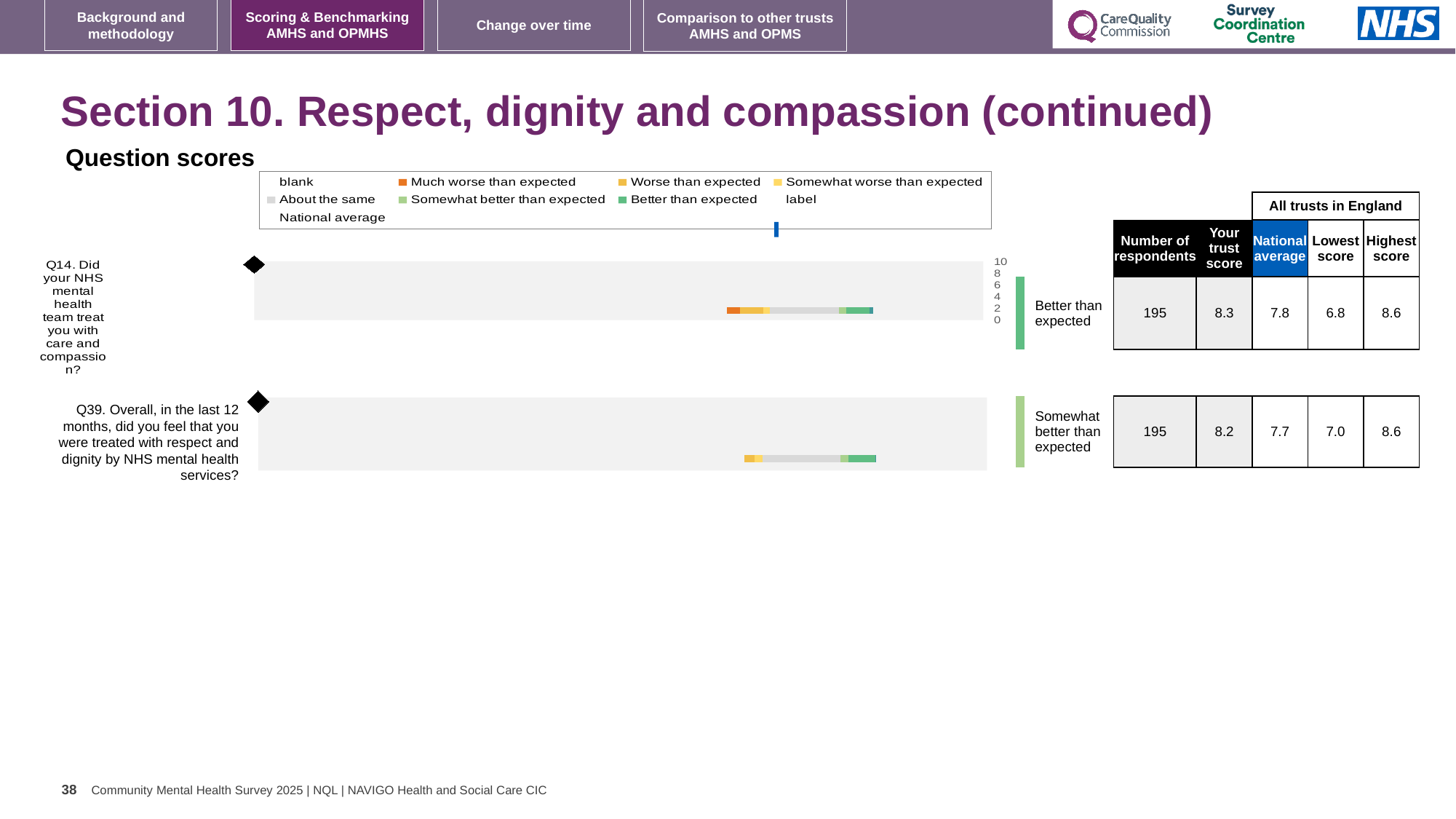
What is the trust score for Q14 in the question scores chart? 8.3 Which legend entry in the question scores chart is shown in orange? Much worse than expected How many entries does the legend of the question scores chart list? 9 What is the difference between the trust score and the national average for Q14? 0.5 What is the lowest score across all trusts in England for Q14? 6.8 How many respondents answered Q39? 195 What kind of chart is used to show the question scores on this slide? bar chart Which question has the higher trust score, Q14 or Q39? Q14 How many questions are plotted in the question scores chart? 2 What rating label is shown next to the bar for Q39 in the question scores chart? Somewhat better than expected What is the national average for Q39 in the question scores chart? 7.7 What rating label is shown next to the bar for Q14 in the question scores chart? Better than expected